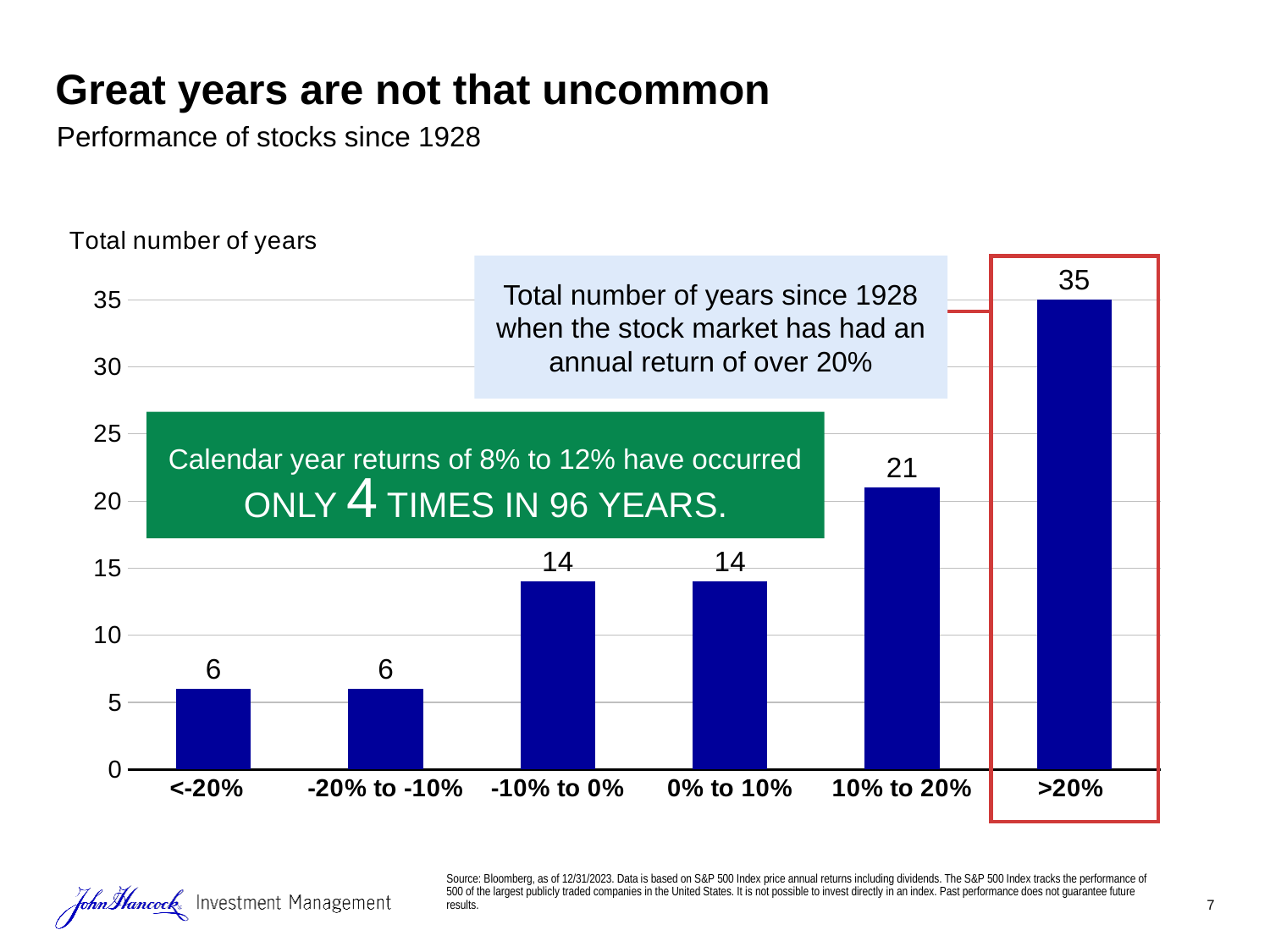
What is the value for the 10% to 20% category? 21 Which is larger, the value for 10% to 20% or the value for -10% to 0%? 10% to 20% Which return range has the highest number of years? >20% Is the value for >20% greater or less than 30? greater What is the difference between the number of years for >20% and for 10% to 20%? 14 What is the value for the <-20% category? 6 What kind of chart is shown on the slide? bar chart What is the difference between the number of years for 0% to 10% and for -20% to -10%? 8 What is the label of the vertical axis of the chart? Total number of years How many return-range categories are shown on the x axis? 6 How many years had an annual return of over 20%? 35 What is the value for the -10% to 0% category? 14